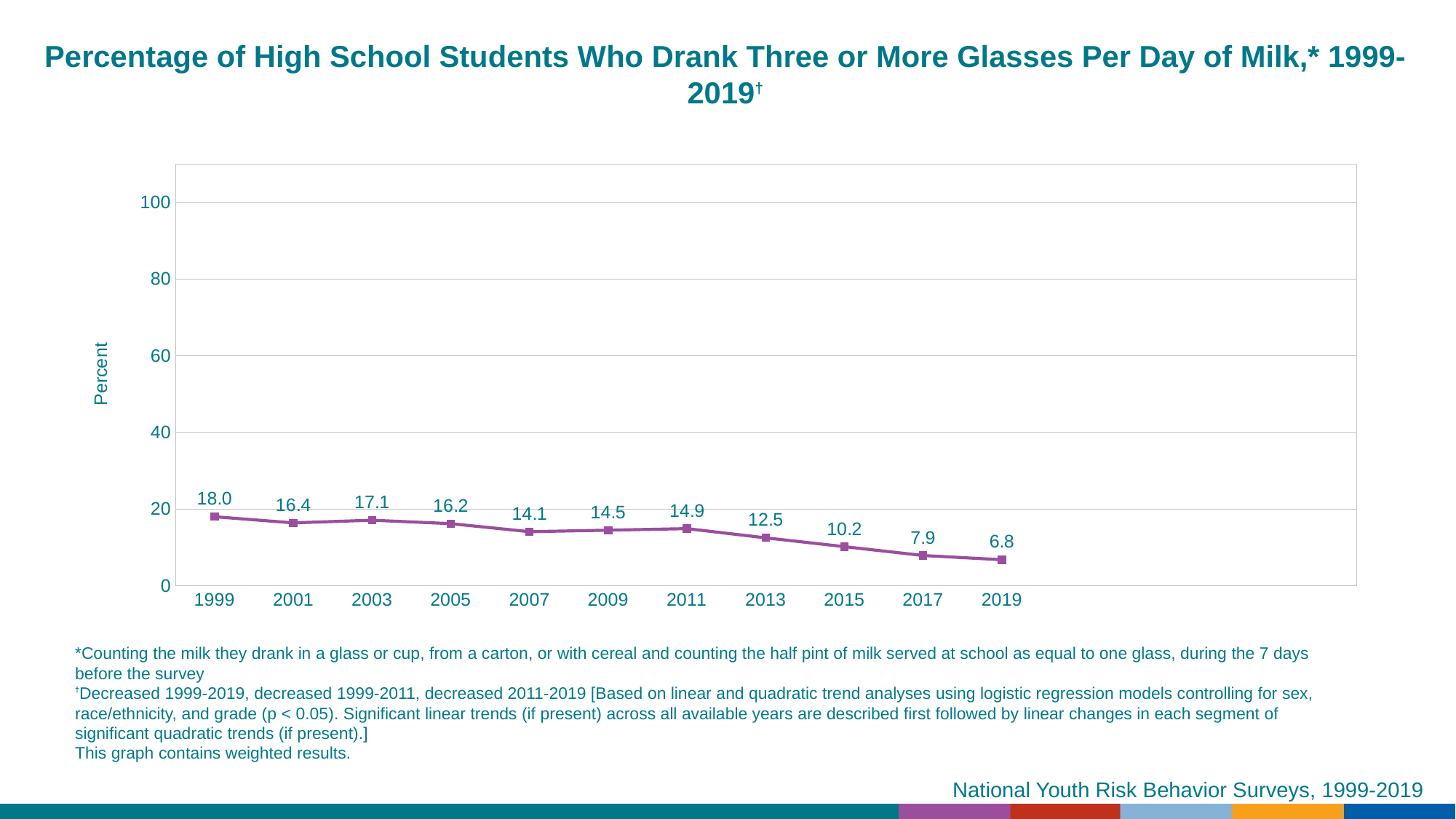
What value is shown for 2011? 14.9 What kind of chart is shown on the slide? line chart What is the label on the vertical axis? Percent Which year has a larger value, 2003 or 2007? 2003 What value is shown for 2019? 6.8 Is the value for 2013 greater or less than 20? less Which year has the lowest value on the chart? 2019 Do the values generally rise or fall from 1999 to 2019? fall What was the percentage of high school students who drank three or more glasses of milk per day in 1999? 18.0 Which year has the highest value on the chart? 1999 What is the difference between the values for 1999 and 2019? 11.2 How many years are plotted on the chart? 11